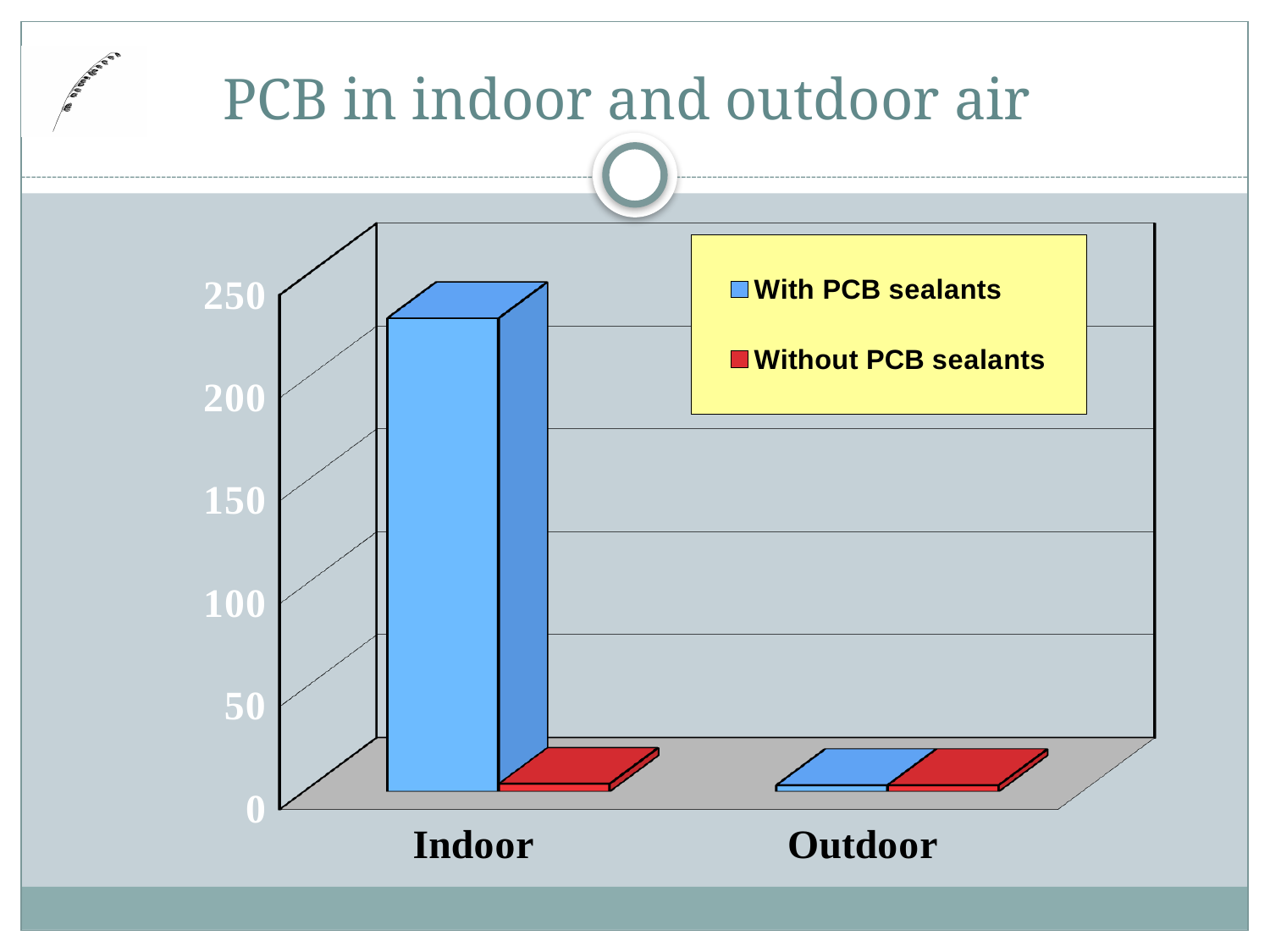
Is the value for Indoor 'Without PCB sealants' greater or less than 50? less Which series is shown in blue in the chart? With PCB sealants Is the value for Indoor 'With PCB sealants' greater or less than 200? greater Which bar is the tallest in the chart? Indoor, With PCB sealants Is the value for Outdoor 'With PCB sealants' greater or less than 50? less For the Indoor category, which is larger: 'With PCB sealants' or 'Without PCB sealants'? With PCB sealants How many categories are shown on the x axis of the chart? 2 Which category has the highest value for the 'With PCB sealants' series? Indoor What kind of chart is shown on the slide? bar chart What is the title of the chart on the slide? PCB in indoor and outdoor air How many series does the legend list? 2